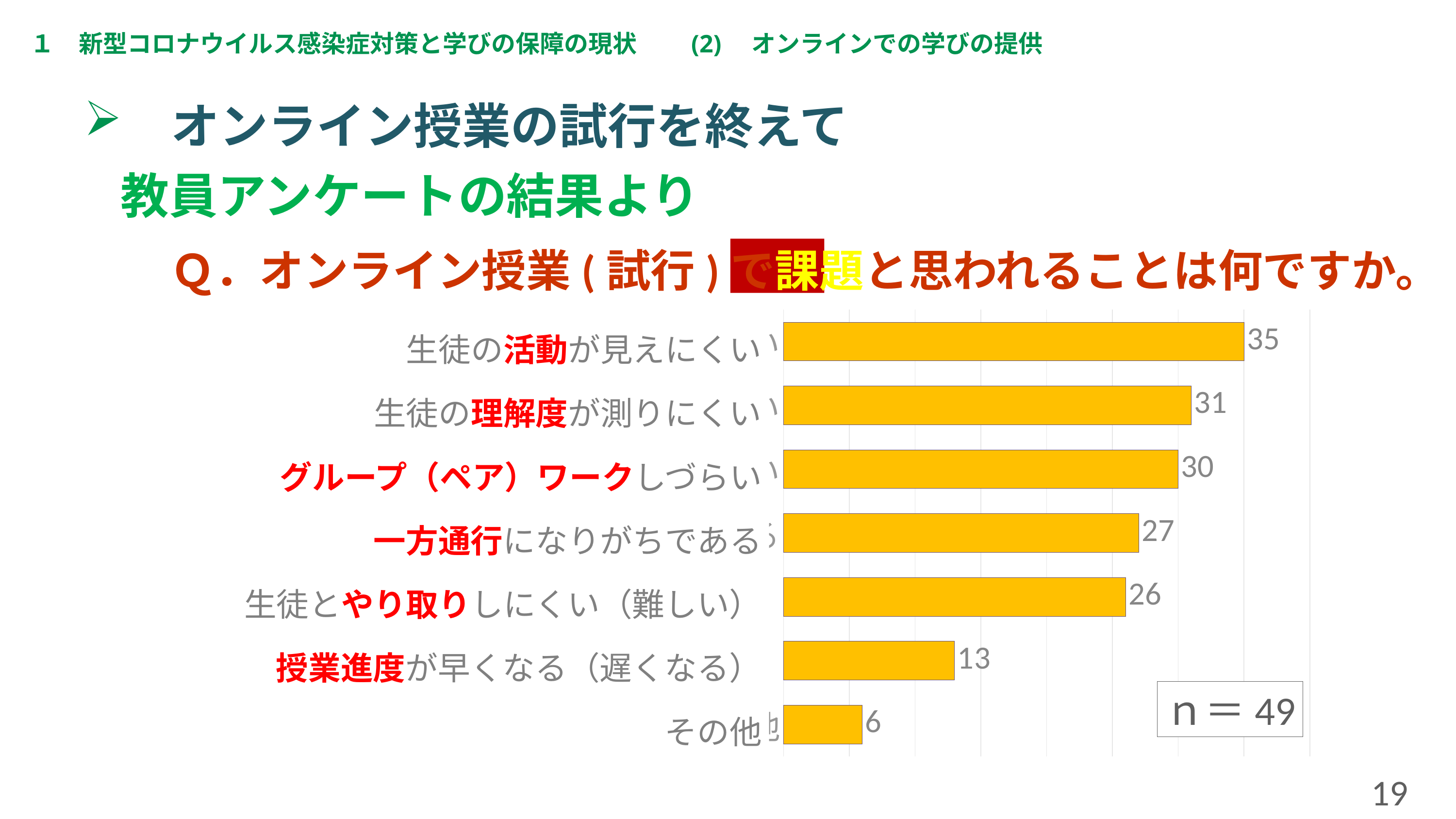
What is the difference between the values for 一方通行になりがちである and 授業進度が早くなる（遅くなる）? 14 What value is shown for 生徒の活動が見えにくい? 35 What value is shown for 授業進度が早くなる（遅くなる）? 13 Which is larger, the value for 生徒とやり取りしにくい（難しい） or the value for 授業進度が早くなる（遅くなる）? 生徒とやり取りしにくい（難しい） What value is shown for グループ（ペア）ワークしづらい? 30 What kind of chart is shown on the slide? bar chart What is the difference between the values for 生徒の活動が見えにくい and 生徒の理解度が測りにくい? 4 How many categories are shown in the chart? 7 Which category has the highest value? 生徒の活動が見えにくい What value is shown for 生徒の理解度が測りにくい? 31 What value is shown for その他? 6 Which category has the lowest value? その他